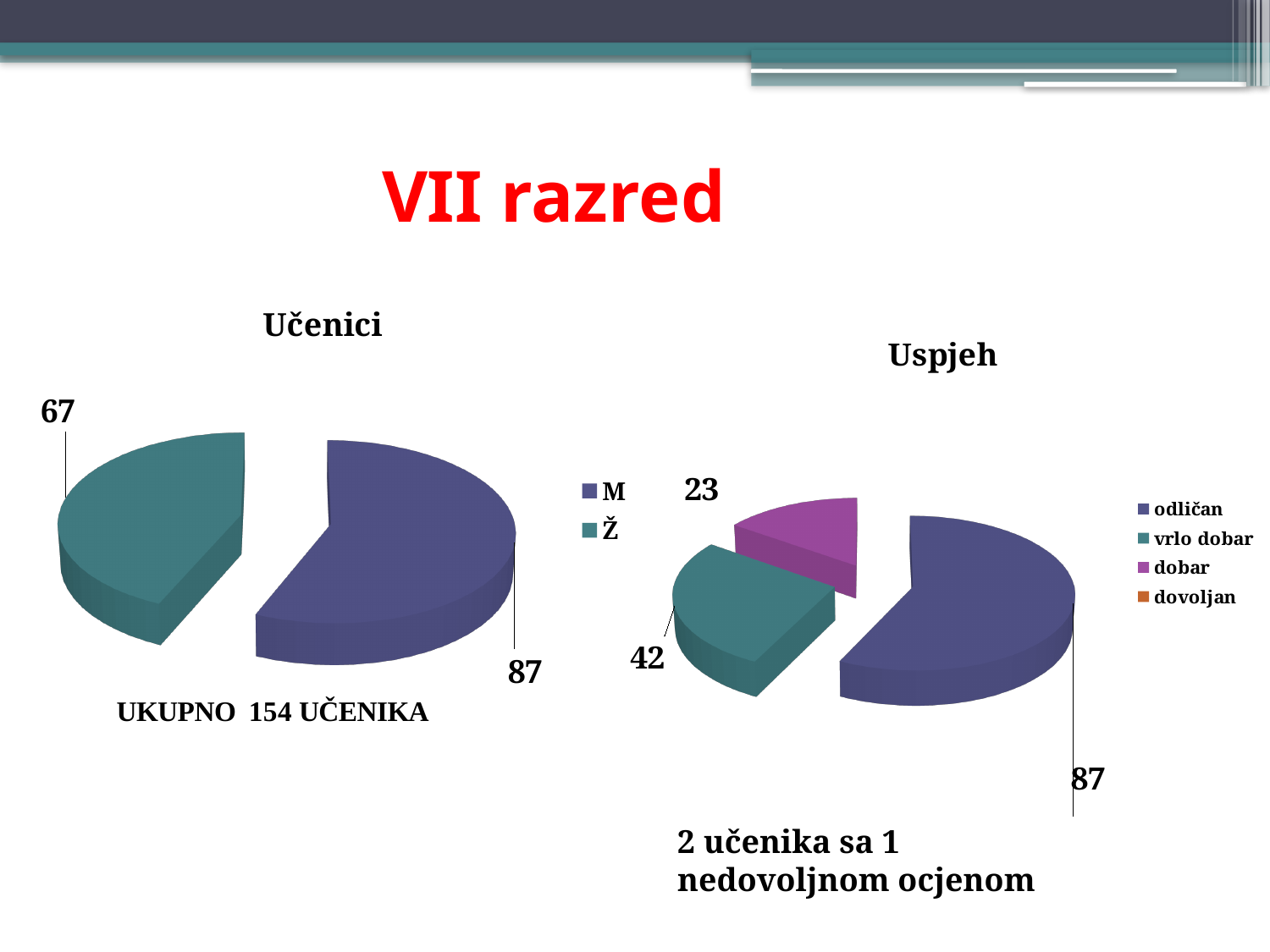
In the 'Učenici' chart, what is the value for Ž? 67 In the 'Učenici' chart, what is the difference between the values for M and Ž? 20 In the 'Učenici' chart, which category is larger, M or Ž? M In the 'Uspjeh' chart, what is the value for vrlo dobar? 42 How many series does the legend of the 'Učenici' chart list? 2 In the 'Uspjeh' chart, which labelled category has the highest value? odličan What kind of chart is the 'Učenici' chart? Pie chart In the 'Učenici' chart, what is the value for M? 87 In the 'Uspjeh' chart, what is the value for dobar? 23 In the 'Uspjeh' chart, what is the value for odličan? 87 How many entries does the legend of the 'Uspjeh' chart list? 4 In the 'Uspjeh' chart, what is the difference between the values for odličan and vrlo dobar? 45